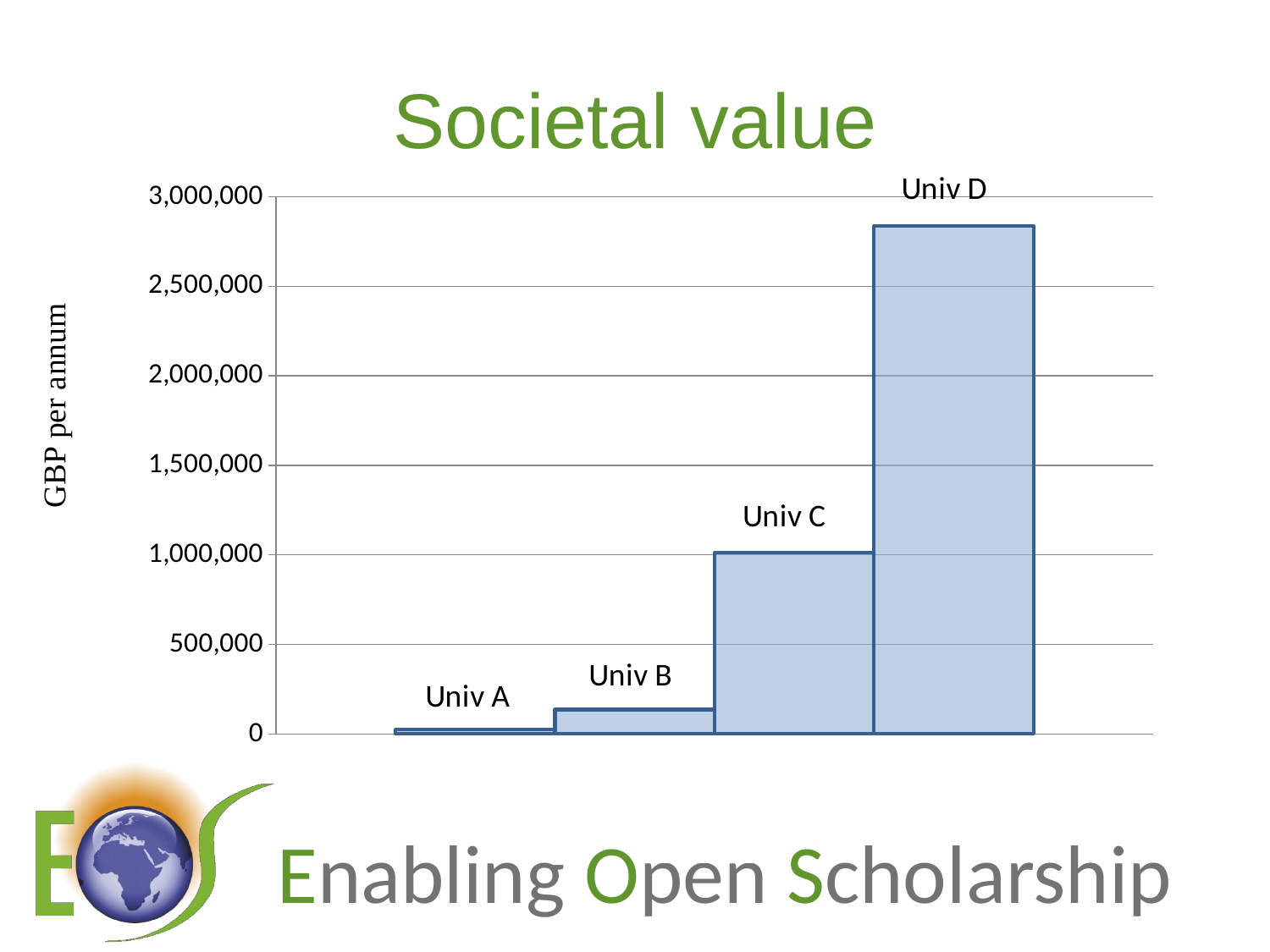
Which has a larger societal value, Univ D or Univ C? Univ D Which has a larger societal value, Univ B or Univ C? Univ C What is the label on the vertical axis of the chart? GBP per annum Is the value for Univ D greater or less than 2,500,000? greater Is the value for Univ B greater or less than 500,000? less Which university has the lowest societal value? Univ A What kind of chart is shown on the slide? bar chart Is the value for Univ C greater or less than 500,000? greater What is the title of the chart? Societal value Which university has the highest societal value? Univ D Do the values rise or fall from Univ A to Univ D along the x axis? rise How many universities are plotted in the chart? 4